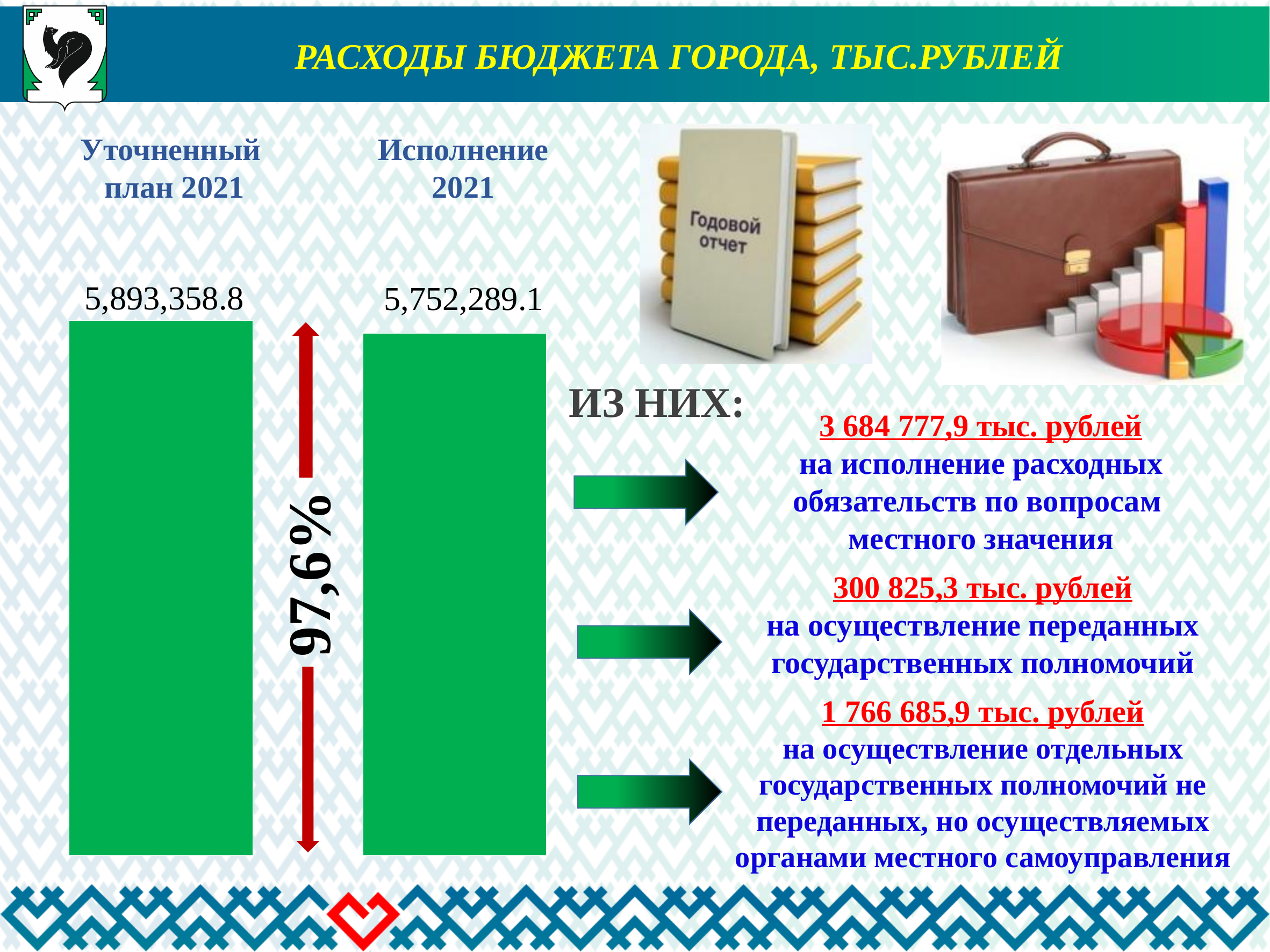
What is the difference between Уточненный план 2021 and Исполнение 2021? 141,069.7 What kind of chart is shown on the slide? Bar chart What is the value for Исполнение 2021? 5,752,289.1 How many bars are shown in the chart? 2 Do the values rise or fall from the left bar to the right bar? Fall What is the title of the slide's chart? РАСХОДЫ БЮДЖЕТА ГОРОДА, ТЫС.РУБЛЕЙ Which category has the lowest value? Исполнение 2021 Which is larger, Уточненный план 2021 or Исполнение 2021? Уточненный план 2021 What percentage is shown between the two bars? 97,6% Which category has the highest value? Уточненный план 2021 What is the value for Уточненный план 2021? 5,893,358.8